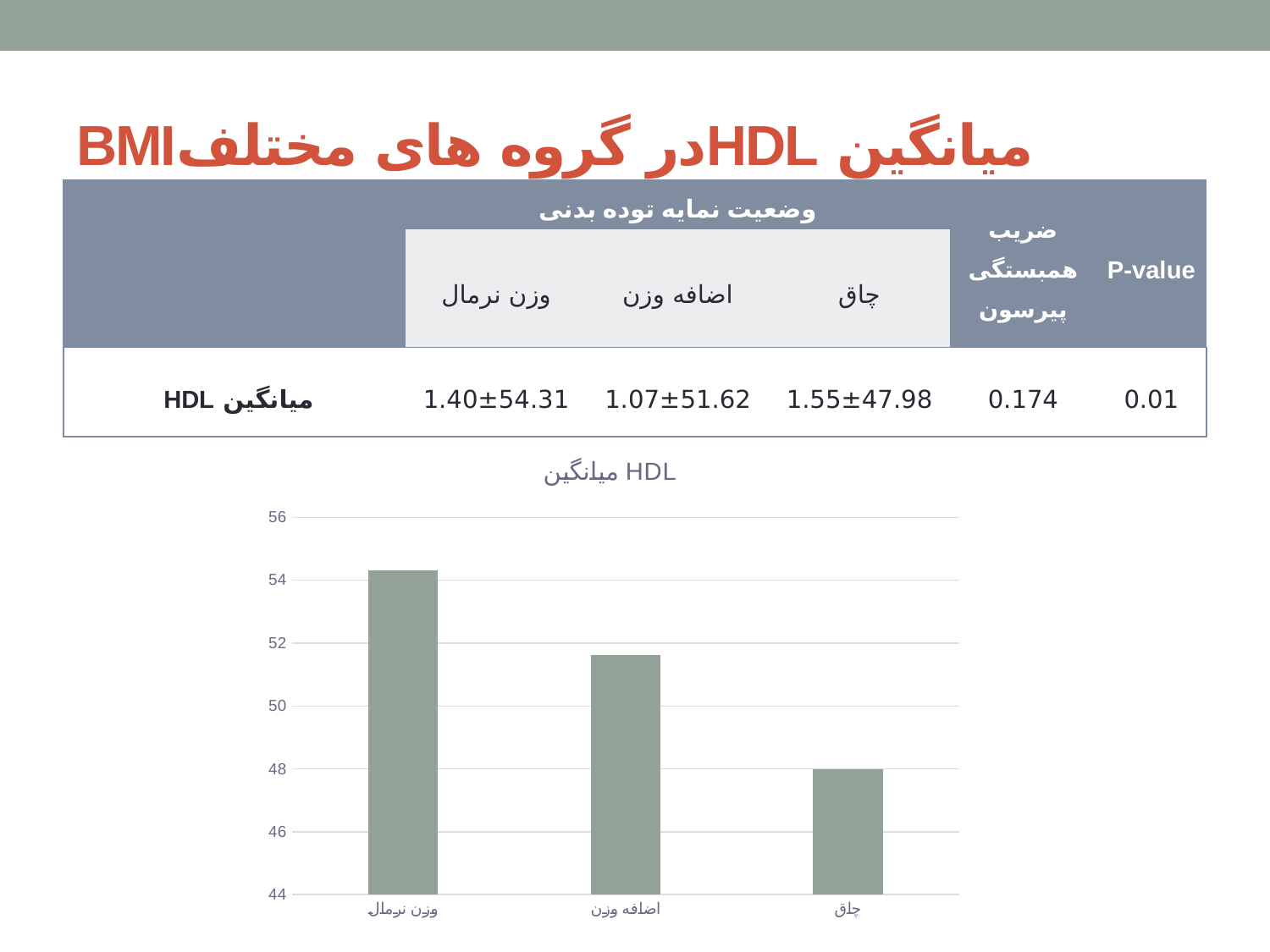
What is the title of the chart? میانگین HDL What is the lowest value shown on the chart's vertical axis? 44 Is the value for اضافه وزن greater or less than 50? greater Is the value for اضافه وزن greater or less than 52? less Do the bar values rise or fall from left to right along the x axis? fall How many categories are shown on the x axis of the chart? 3 Which is larger, the bar for اضافه وزن or the bar for چاق? اضافه وزن Which category has the highest bar in the chart? وزن نرمال Is the value for وزن نرمال greater or less than 54? greater Which category has the lowest bar in the chart? چاق What kind of chart is shown on the slide? bar chart